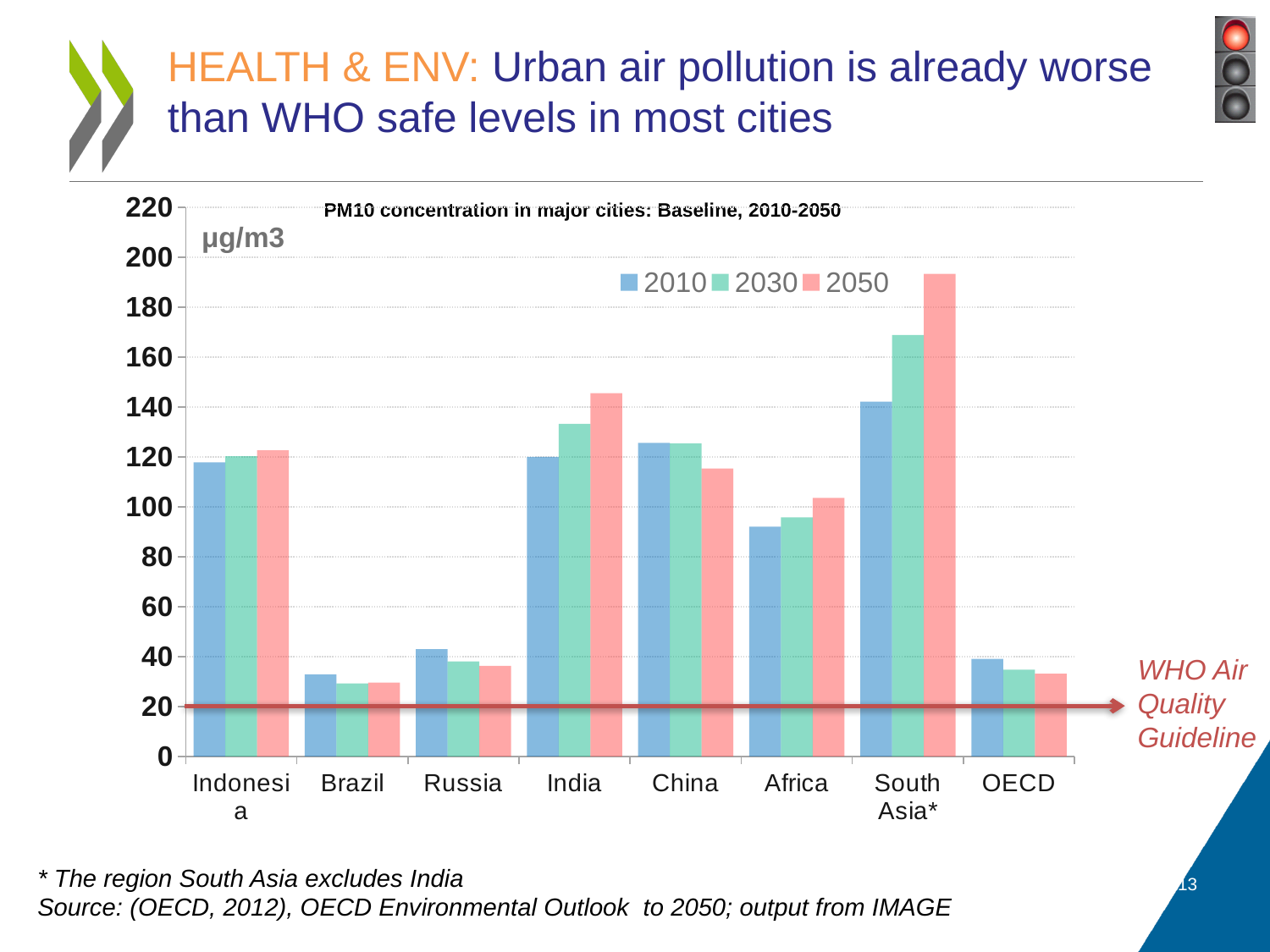
Which region has the lowest PM10 concentration for 2010? Brazil What is the title of the chart? PM10 concentration in major cities: Baseline, 2010-2050 Is the 2050 value for South Asia* greater or less than 180? greater Is the 2010 value for Africa greater or less than 100? less Do the values for Russia rise or fall from 2010 to 2050? fall What kind of chart is shown on the slide? Bar chart Which is larger, the 2050 value for India or the 2050 value for China? India How many series does the legend list? 3 How many regions are shown on the x axis? 8 Do the values for South Asia* rise or fall from 2010 to 2050? rise Is the 2050 value for India greater or less than 140? greater Which region has the highest PM10 concentration for 2050? South Asia*